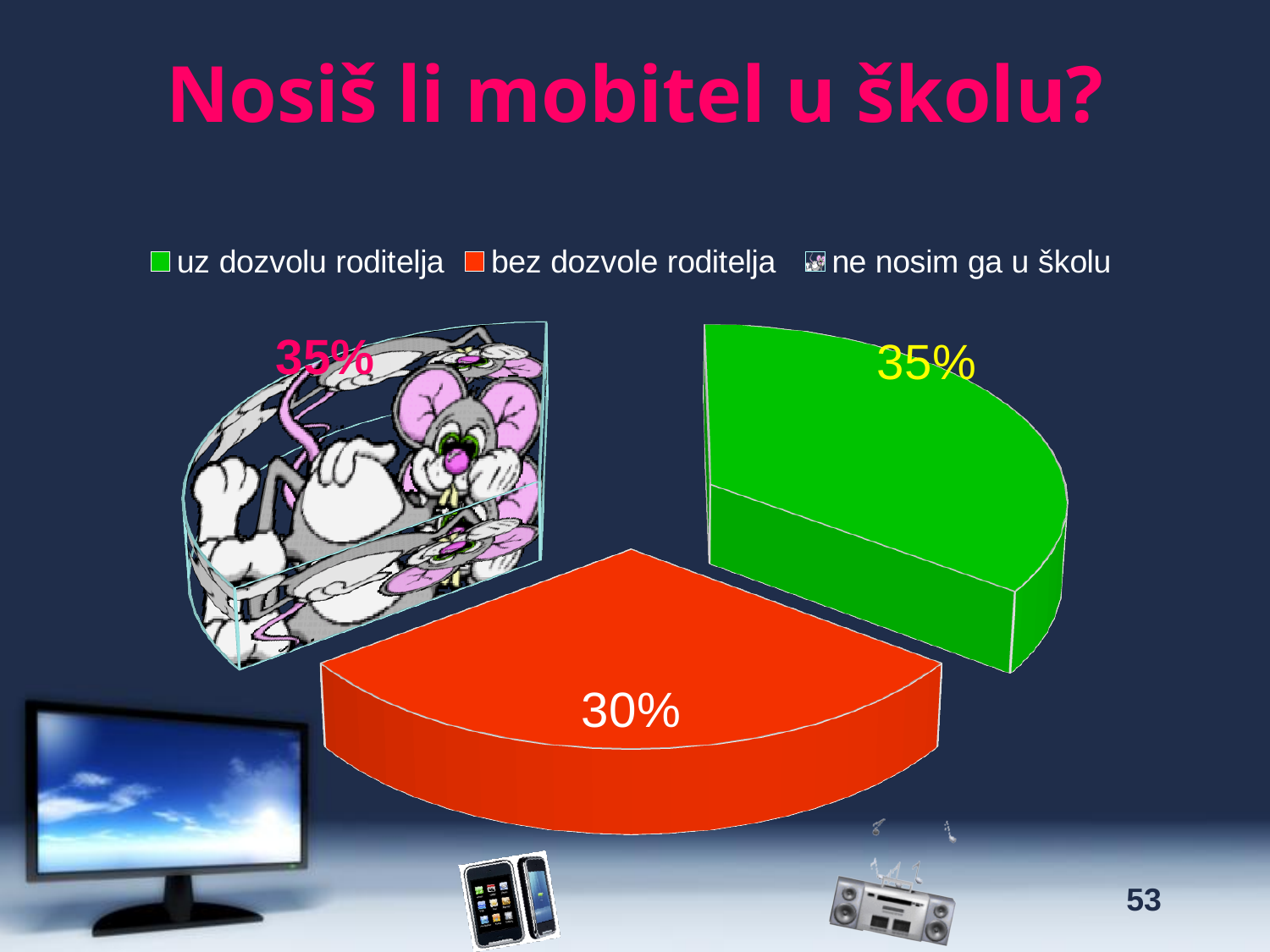
What is the difference in percentage points between the "uz dozvolu roditelja" slice and the "bez dozvole roditelja" slice? 5 percentage points What colour is the slice for "uz dozvolu roditelja"? green What kind of chart is shown on the slide? pie chart What percentage of the pie is labelled for "bez dozvole roditelja"? 30% Which category has the smallest slice of the pie? bez dozvole roditelja What share of the pie does the "bez dozvole roditelja" slice represent? 30% What percentage of the pie is labelled for "ne nosim ga u školu"? 35% How many slices does the pie chart have? 3 How many entries does the legend list? 3 What is the title of the slide containing the pie chart? Nosiš li mobitel u školu? Which is larger, the slice for "uz dozvolu roditelja" or the slice for "bez dozvole roditelja"? uz dozvolu roditelja What percentage of the pie is labelled for "uz dozvolu roditelja"? 35%